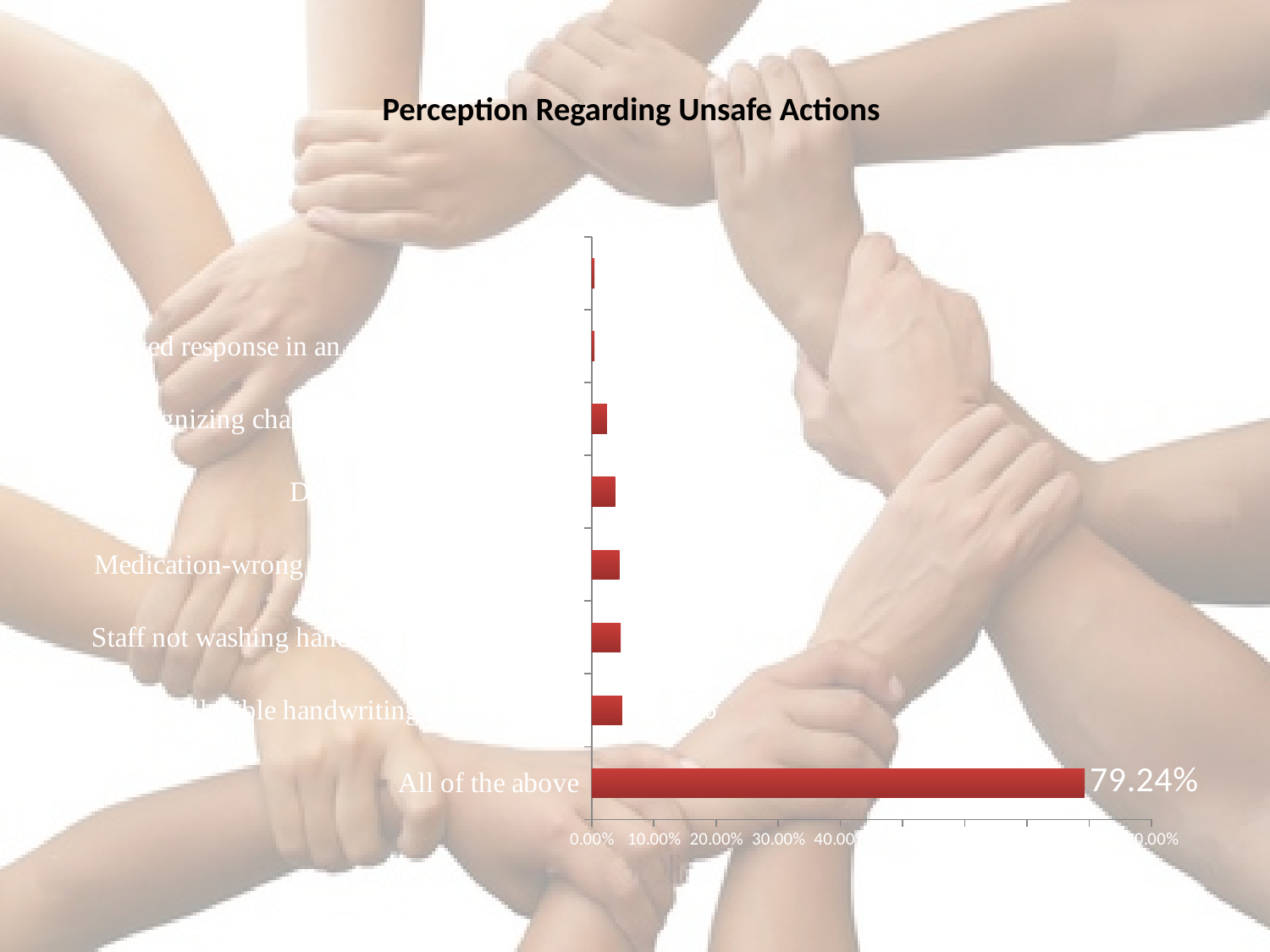
Is the value for "Staff not washing hands" greater or less than 10.00%? less What is the lowest tick value shown on the horizontal axis? 0.00% Which is larger, the value for "All of the above" or the value for "Staff not washing hands"? All of the above What colour are the bars in the chart? red Is the value for "All of the above" greater or less than 70.00%? greater What kind of chart is shown on the slide? bar chart Which category has the highest value? All of the above What is the value for "All of the above"? 79.24% How many bars are plotted in the chart? 8 What is the title of the chart? Perception Regarding Unsafe Actions